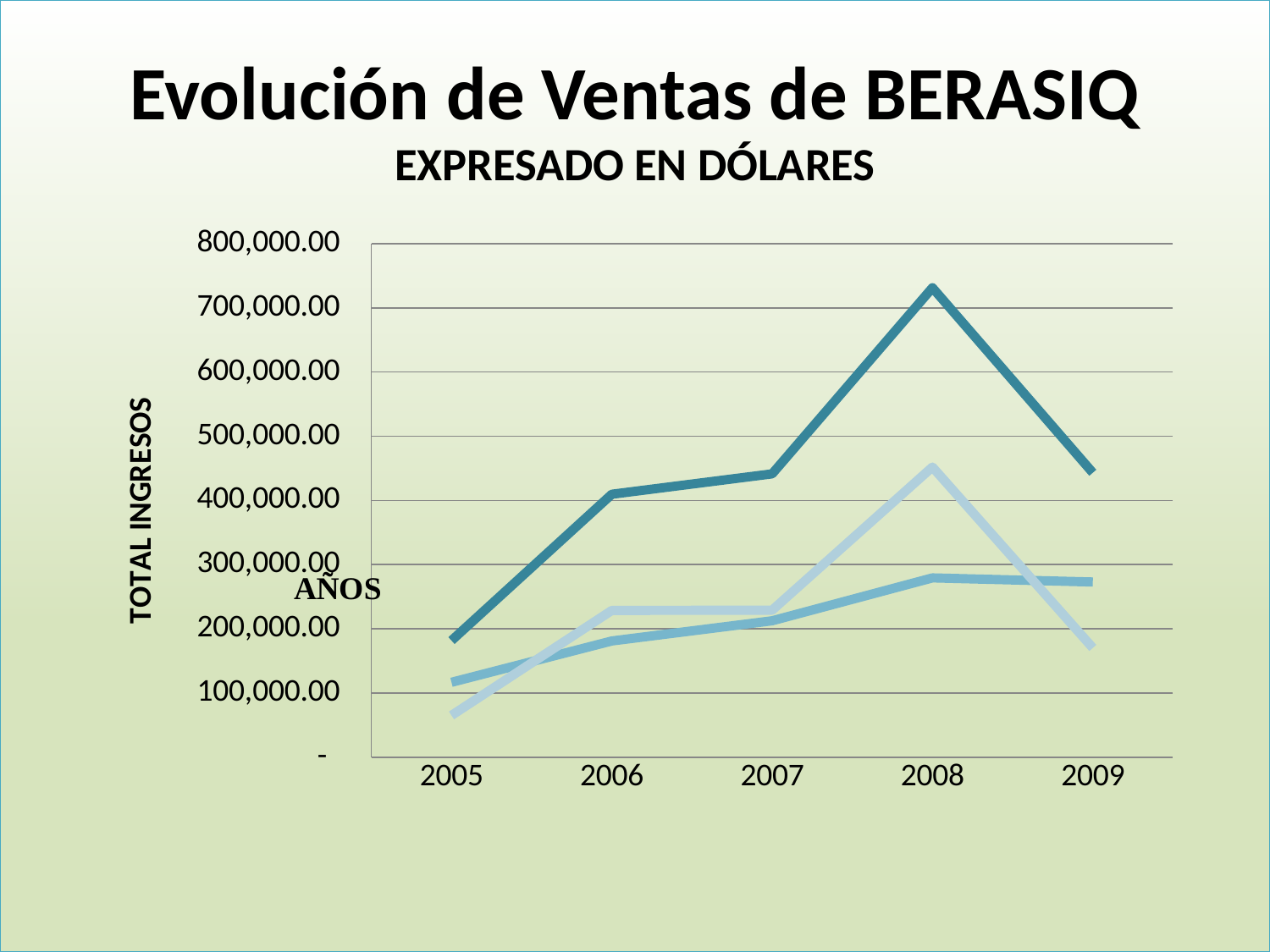
What is the label on the vertical axis of the chart? TOTAL INGRESOS Is the value of the dark teal line in 2005 greater or less than 200,000.00? less How many lines are plotted on the chart? 3 Is the value of the dark teal line in 2008 greater or less than 700,000.00? greater In which year does the dark teal line have its lowest value? 2005 Is the value of the light blue line in 2008 greater or less than 500,000.00? less In which year does the dark teal line reach its highest value? 2008 In which year does the light blue line have its lowest value? 2005 How many years are shown on the x axis of the chart? 5 What kind of chart is shown on the slide? line chart In 2009, which line has the higher value: the dark teal line or the light blue line? the dark teal line Does the dark teal line rise or fall from 2005 to 2008? rise